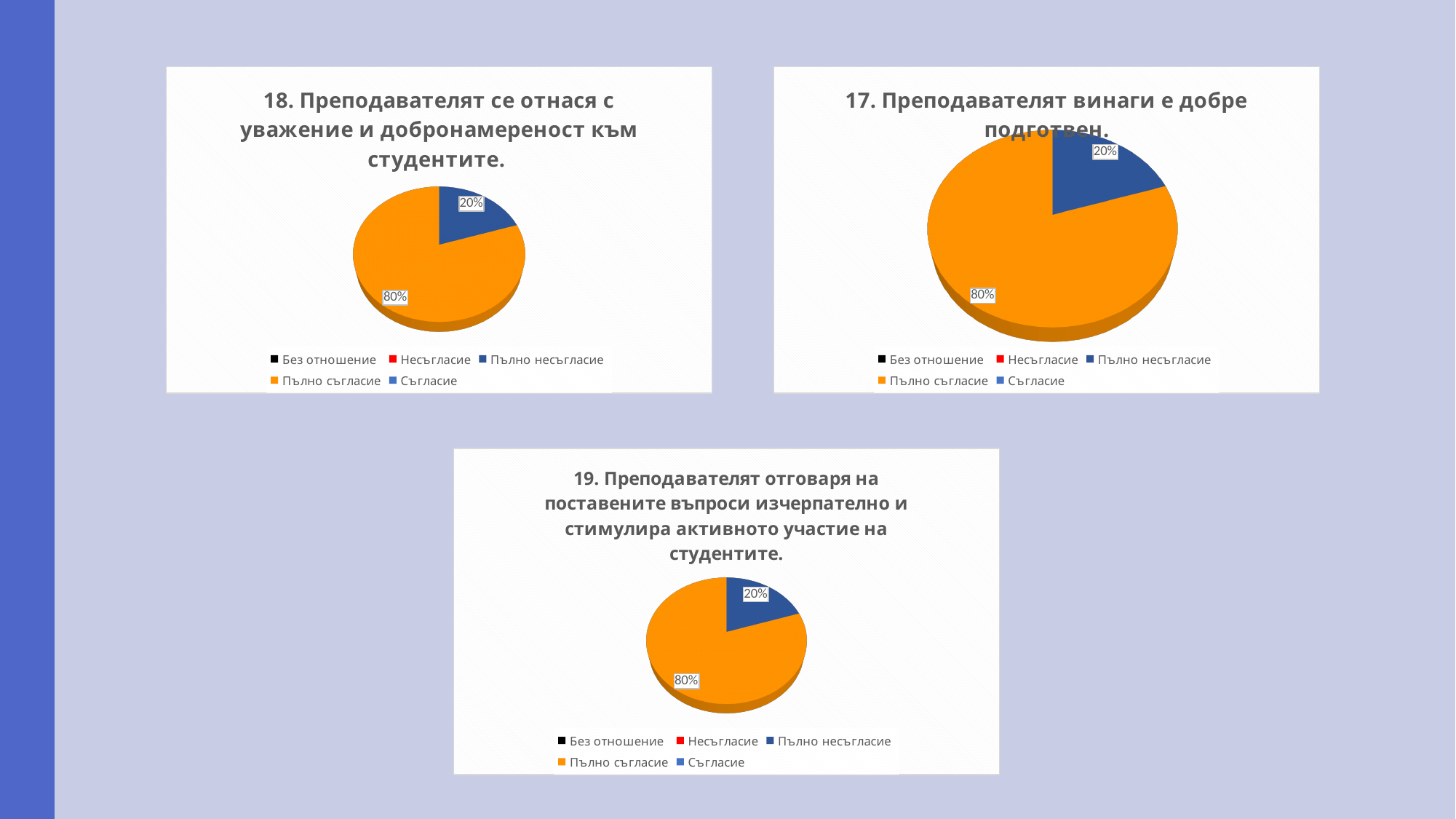
How many entries does the legend list in the chart titled "17. Преподавателят винаги е добре подготвен."? 5 In the chart titled "17. Преподавателят винаги е добре подготвен.", which is larger, the orange slice or the blue slice? The orange slice How many pie charts are shown on the slide? 3 In the chart titled "18. Преподавателят се отнася с уважение и добронамереност към студентите.", which category has the largest slice? Пълно съгласие What kind of chart is the chart titled "17. Преподавателят винаги е добре подготвен."? Pie chart In the chart titled "17. Преподавателят винаги е добре подготвен.", what share does the blue slice have? 20% In the chart titled "19. Преподавателят отговаря на поставените въпроси изчерпателно и стимулира активното участие на студентите.", how many slices are visible in the pie? 2 In the chart titled "19. Преподавателят отговаря на поставените въпроси изчерпателно и стимулира активното участие на студентите.", what share does Пълно съгласие have? 80% In the chart titled "18. Преподавателят се отнася с уважение и добронамереност към студентите.", what colour is the slice for Пълно съгласие? Orange In the chart titled "18. Преподавателят се отнася с уважение и добронамереност към студентите.", what is the difference between the orange slice and the blue slice? 60% In the chart titled "19. Преподавателят отговаря на поставените въпроси изчерпателно и стимулира активното участие на студентите.", is the share for Пълно съгласие greater or less than 50%? greater In the chart titled "18. Преподавателят се отнася с уважение и добронамереност към студентите.", what share does the orange slice (Пълно съгласие) have? 80%